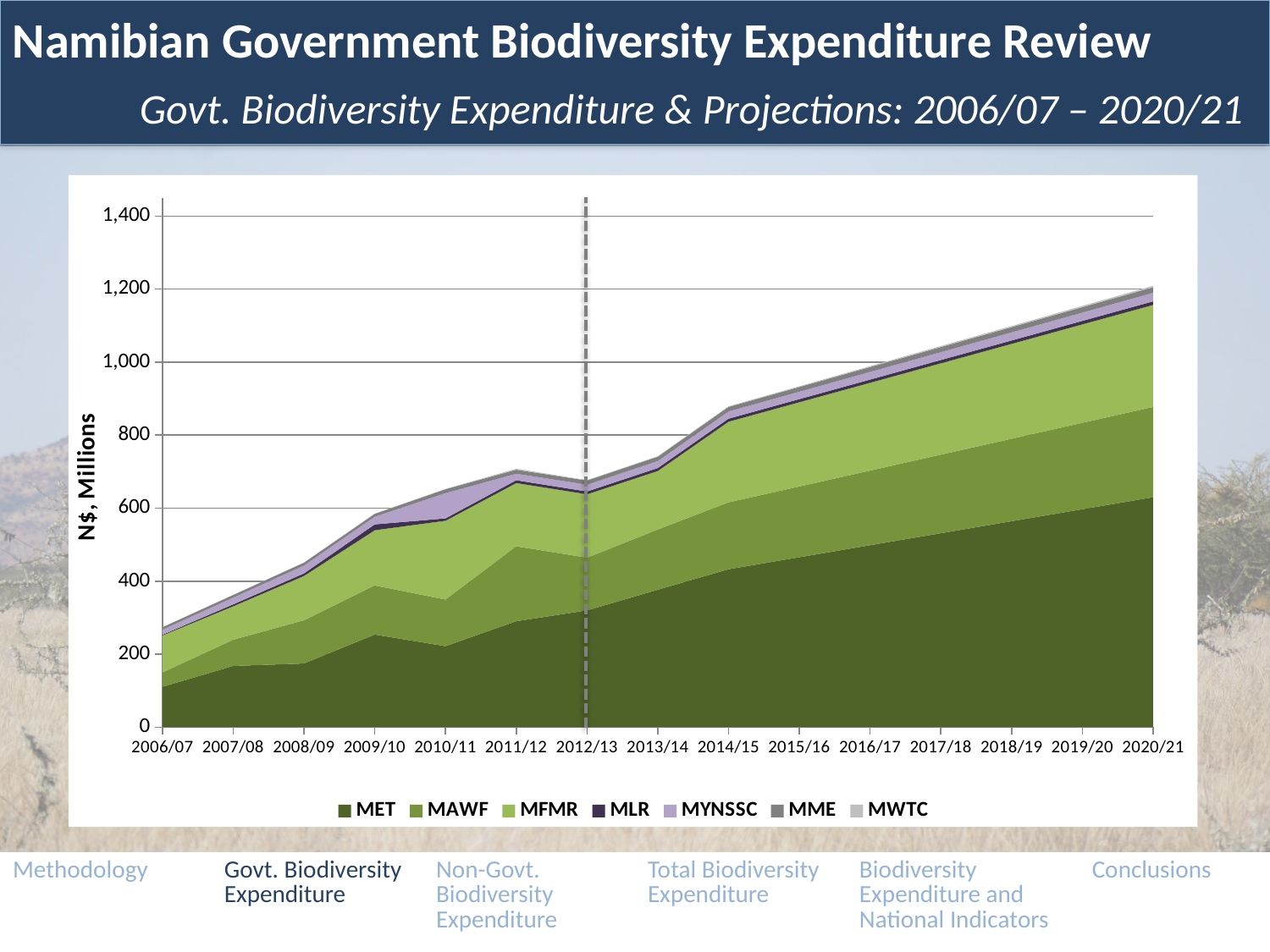
Is the total expenditure for 2006/07 greater or less than 400? less Which fiscal year has the highest total expenditure in the chart? 2020/21 What is the label on the y axis of the chart? N$, Millions How many fiscal years are shown along the x axis of the chart? 15 Does the total government biodiversity expenditure rise or fall from 2006/07 to 2020/21? Rises Which fiscal year has the lowest total expenditure in the chart? 2006/07 Is the total expenditure for 2020/21 greater or less than 1,000? greater Is the MET value for 2020/21 greater or less than 400? greater How many series does the chart's legend list? 7 What kind of chart is shown on the slide? Stacked area chart Which series is listed first in the chart's legend? MET